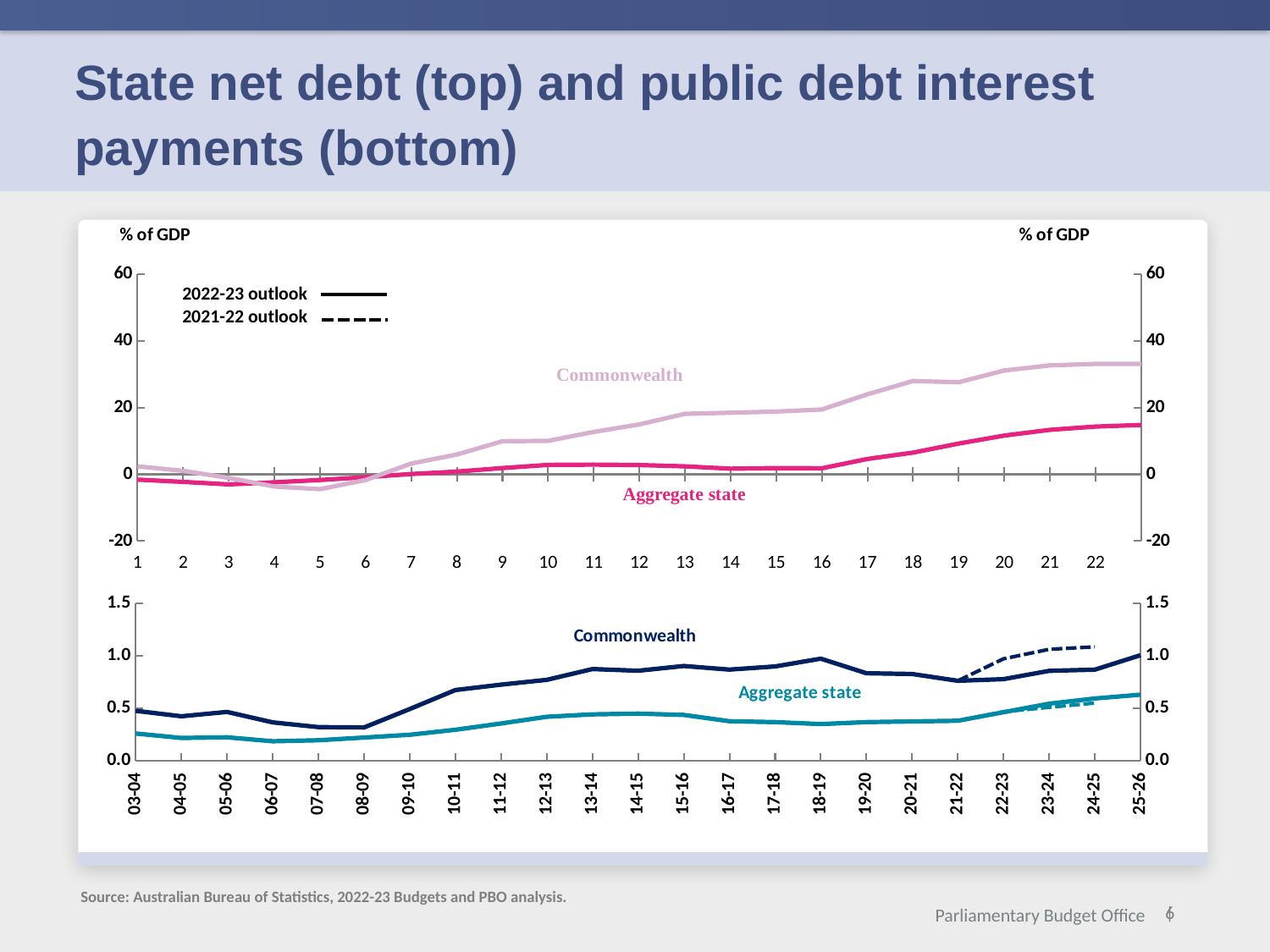
On the top chart (State net debt), does the Commonwealth line rise or fall from point 7 to point 22? rise On the top chart (State net debt), is the Commonwealth value at point 22 greater or less than 20? greater On the bottom chart (public debt interest payments), which series is higher at 25-26, Commonwealth or Aggregate state? Commonwealth On the top chart (State net debt), is the Aggregate state value at point 22 greater or less than 20? less On the top chart (State net debt), which series is higher at point 22, Commonwealth or Aggregate state? Commonwealth What kind of chart is the top chart (State net debt)? line chart On the bottom chart (public debt interest payments), is the Commonwealth value for 18-19 greater or less than 0.5? greater What unit is shown on the y axis of the top chart? % of GDP How many entries does the legend on the top chart list? 2 How many categories are shown on the x axis of the bottom chart (public debt interest payments)? 23 On the top chart, which line style represents the 2021-22 outlook? dashed